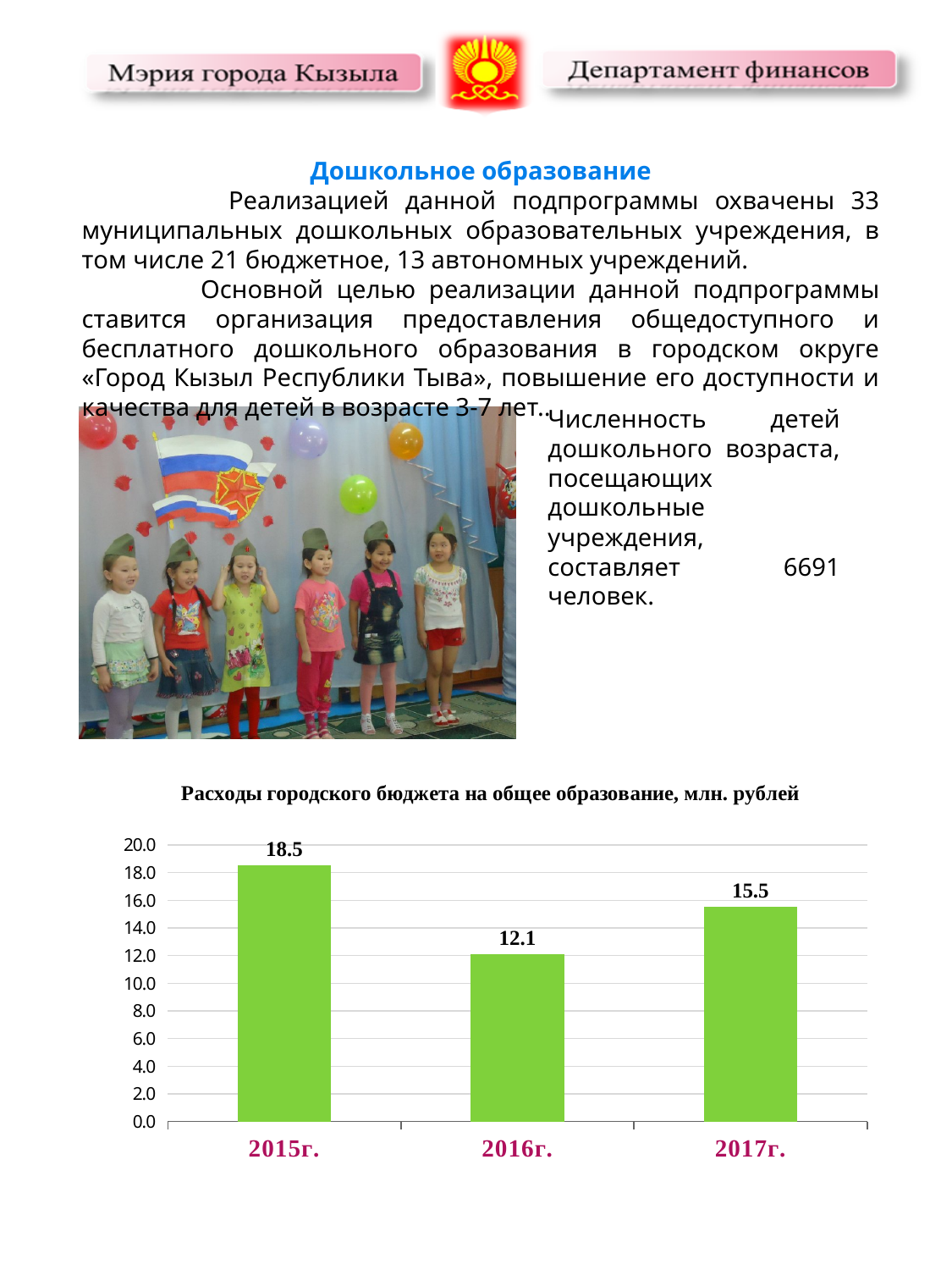
Which year has the lowest value in the chart? 2016г. What is the difference between the values for 2017г. and 2016г.? 3.4 Which is larger, the value for 2017г. or the value for 2016г.? 2017г. What is the value for 2015г. in the chart? 18.5 What is the difference between the values for 2015г. and 2016г.? 6.4 How many years are shown in the chart? 3 What is the title of the chart? Расходы городского бюджета на общее образование, млн. рублей What kind of chart is shown on the slide? bar chart What is the value for 2017г. in the chart? 15.5 What is the value for 2016г. in the chart? 12.1 Which year has the highest value in the chart? 2015г. Is the value for 2016г. greater or less than 14.0? less